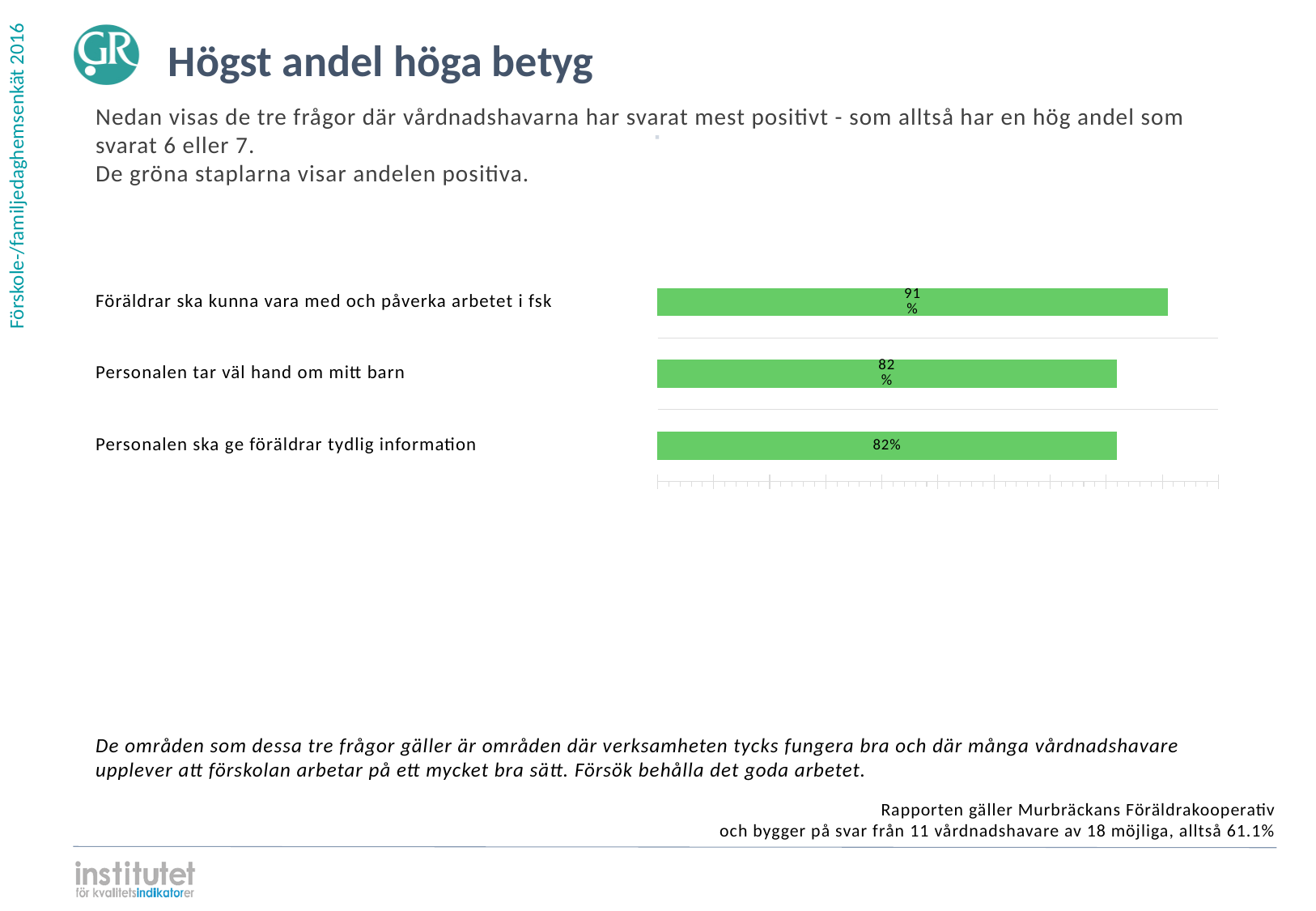
Do "Personalen tar väl hand om mitt barn" and "Personalen ska ge föräldrar tydlig information" have the same value? Yes What colour are the bars in the chart? Green Which category has the highest value? Föräldrar ska kunna vara med och påverka arbetet i fsk Which is larger: the value for "Föräldrar ska kunna vara med och påverka arbetet i fsk" or the value for "Personalen ska ge föräldrar tydlig information"? Föräldrar ska kunna vara med och påverka arbetet i fsk What is the title of the slide containing the chart? Högst andel höga betyg What is the value for "Personalen ska ge föräldrar tydlig information"? 82% What is the difference between the value for "Föräldrar ska kunna vara med och påverka arbetet i fsk" and the value for "Personalen tar väl hand om mitt barn"? 9% How many categories are shown in the chart? 3 What kind of chart is shown on the slide? Bar chart Do the values rise or fall from the top bar to the bottom bar? Fall What is the value for "Personalen tar väl hand om mitt barn"? 82% What is the value for "Föräldrar ska kunna vara med och påverka arbetet i fsk"? 91%